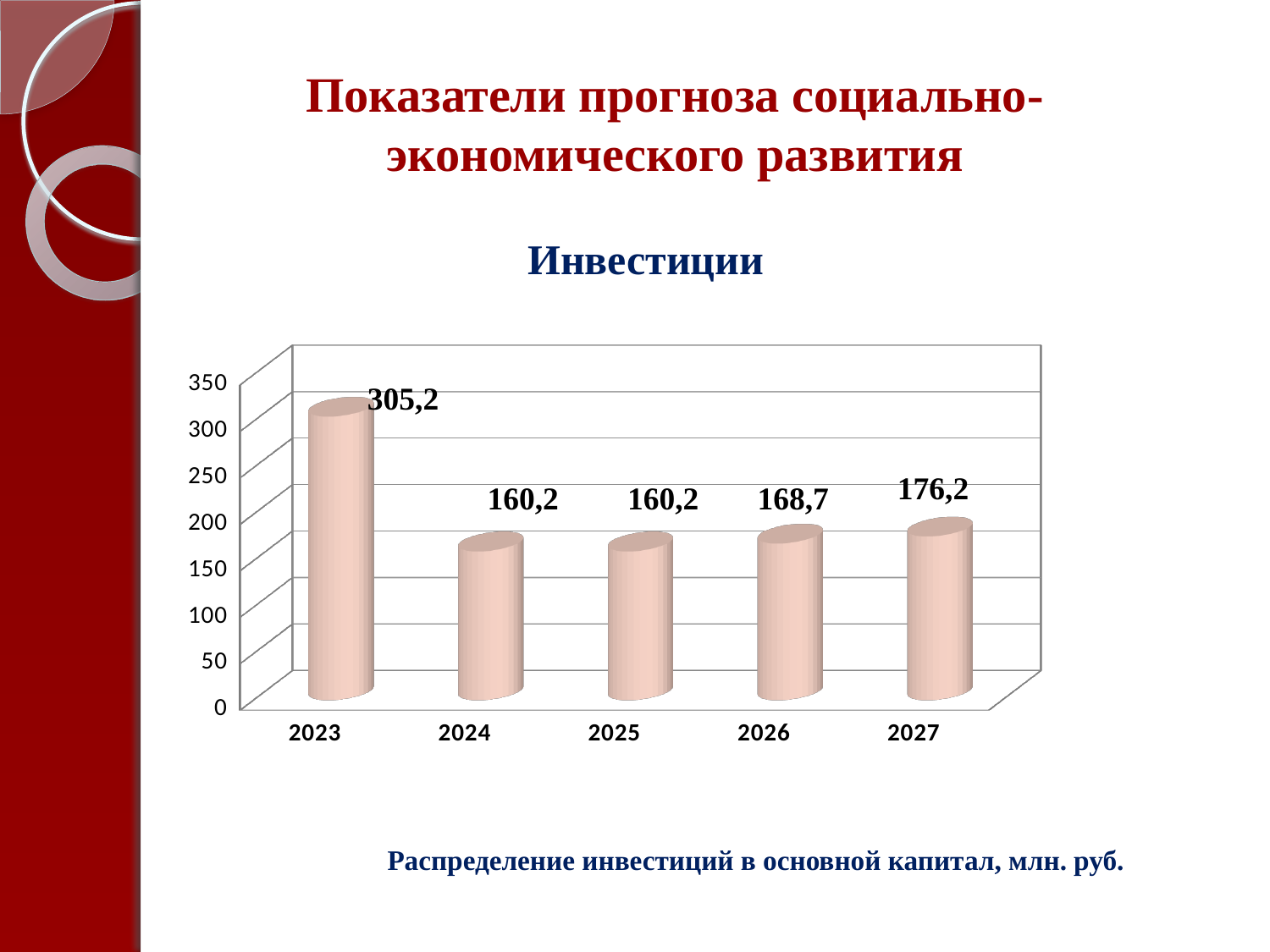
Which is larger, the value for 2026 or the value for 2027? 2027 How many years are shown on the x axis? 5 Do the values rise or fall from 2024 to 2027? rise What kind of chart is shown on the slide? bar chart What is the value for 2027? 176,2 What is the value for 2026? 168,7 What is the value for 2023? 305,2 Which year has the highest value? 2023 Is the value for 2023 greater or less than 300? greater What is the title of the chart? Инвестиции What is the difference between the values for 2023 and 2024? 145,0 What is the difference between the values for 2027 and 2026? 7,5